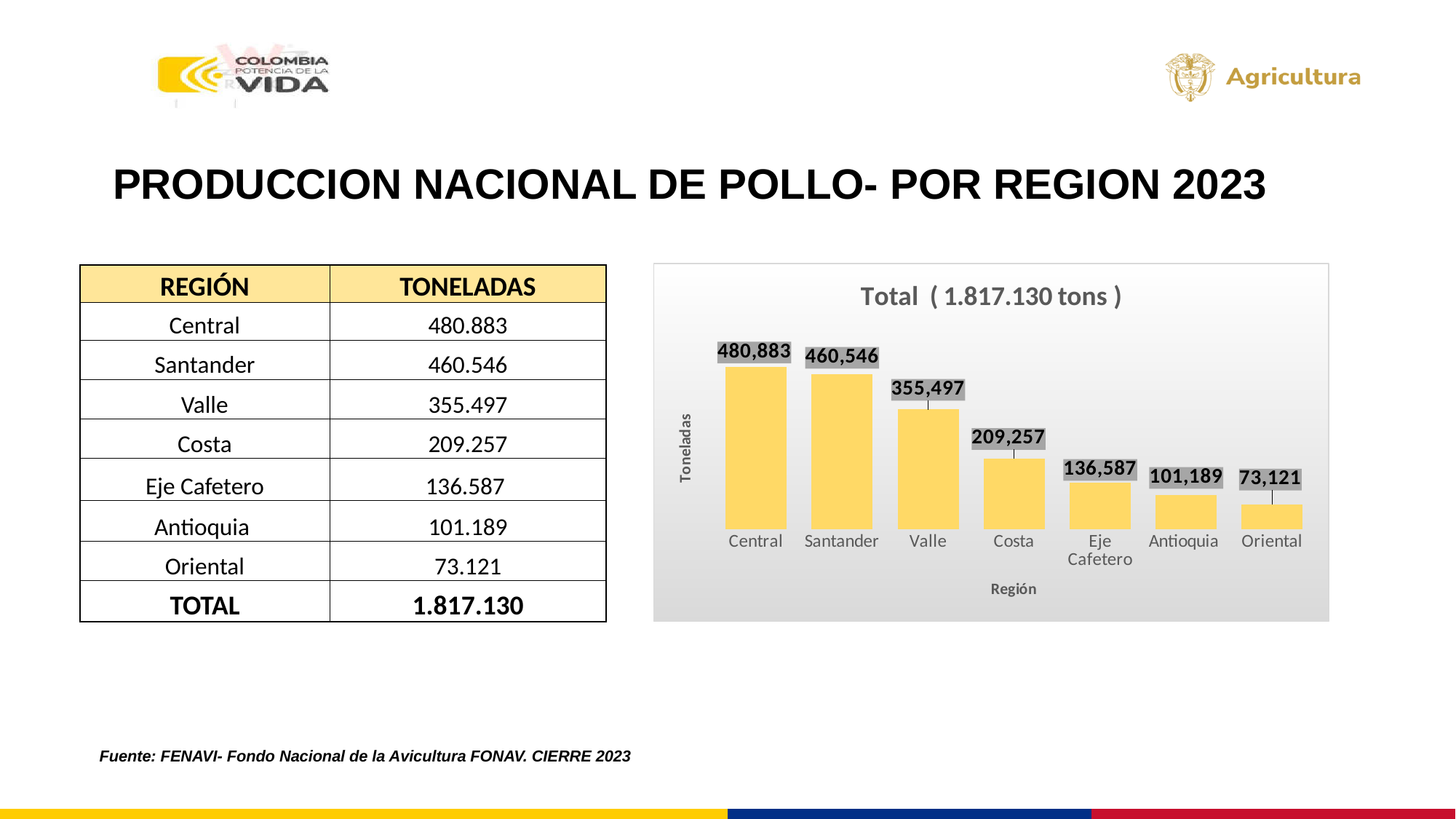
What is the title of the chart? Total ( 1.817.130 tons ) Which region has the highest value in the chart? Central Which is larger, the value for Antioquia or the value for Oriental? Antioquia How many regions are plotted in the chart? 7 What is the value shown for Valle in the chart? 355,497 Which region has the lowest value in the chart? Oriental What is the difference between the values for Central and Santander? 20,337 What is the value shown for Oriental in the chart? 73,121 What is the value shown for Central in the chart? 480,883 What kind of chart is shown on the slide? Bar chart What is the difference between the values for Valle and Costa? 146,240 What is the value shown for Eje Cafetero in the chart? 136,587